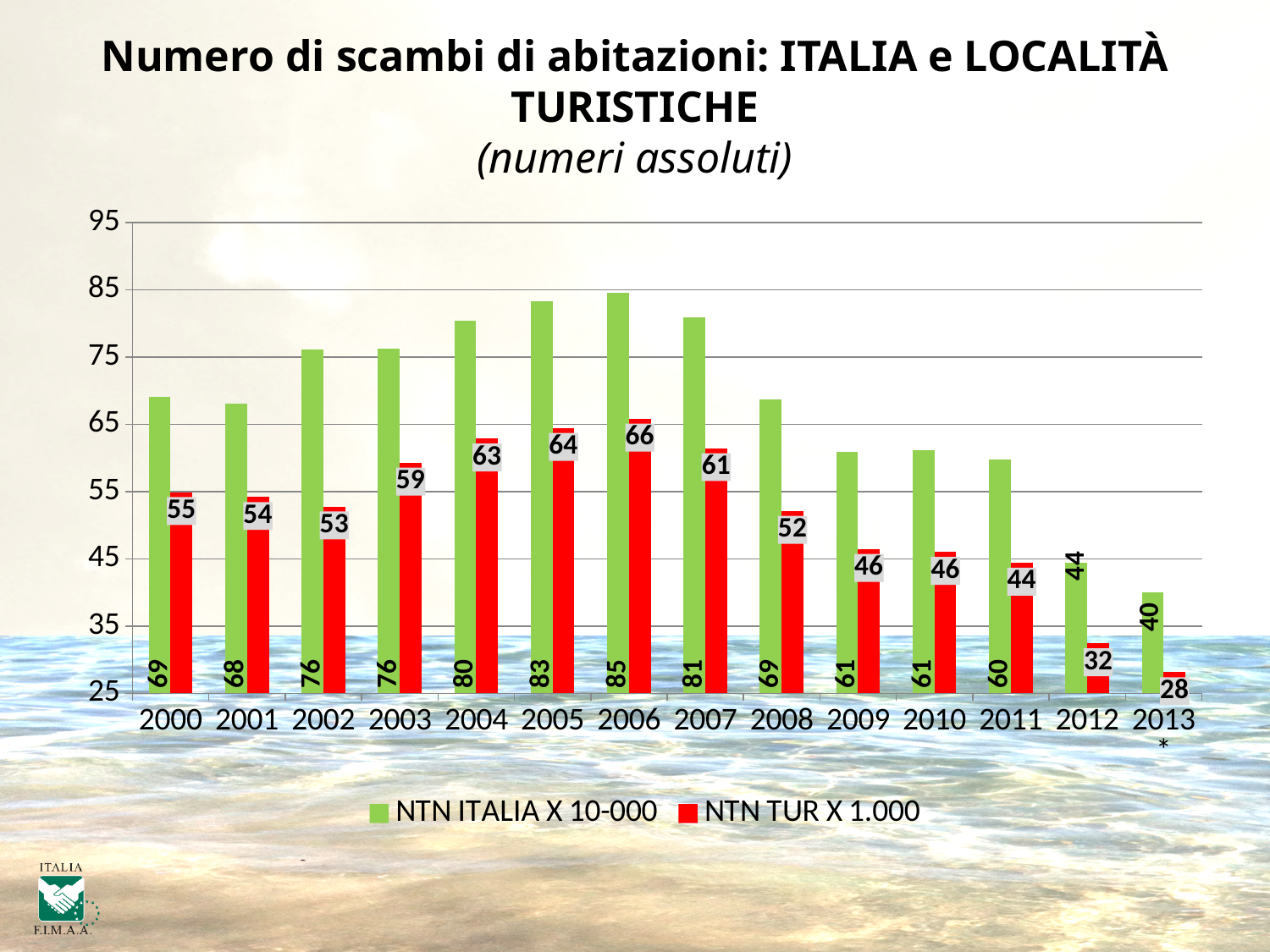
What kind of chart is shown on the slide? Bar chart How many series does the legend list? 2 Which year has the lowest value for NTN TUR X 1.000? 2013* Do the NTN ITALIA X 10-000 values rise or fall from 2007 to 2013*? Fall What colour are the bars for the NTN TUR X 1.000 series? Red What is the difference between the NTN ITALIA X 10-000 values for 2006 and 2013*? 45 What is the value of NTN TUR X 1.000 for 2013*? 28 Which year has the highest value for NTN ITALIA X 10-000? 2006 What is the value of NTN TUR X 1.000 for 2003? 59 Which is larger, the NTN TUR X 1.000 value for 2004 or for 2008? 2004 How many years are shown on the x axis? 14 What is the value of NTN ITALIA X 10-000 for 2006? 85